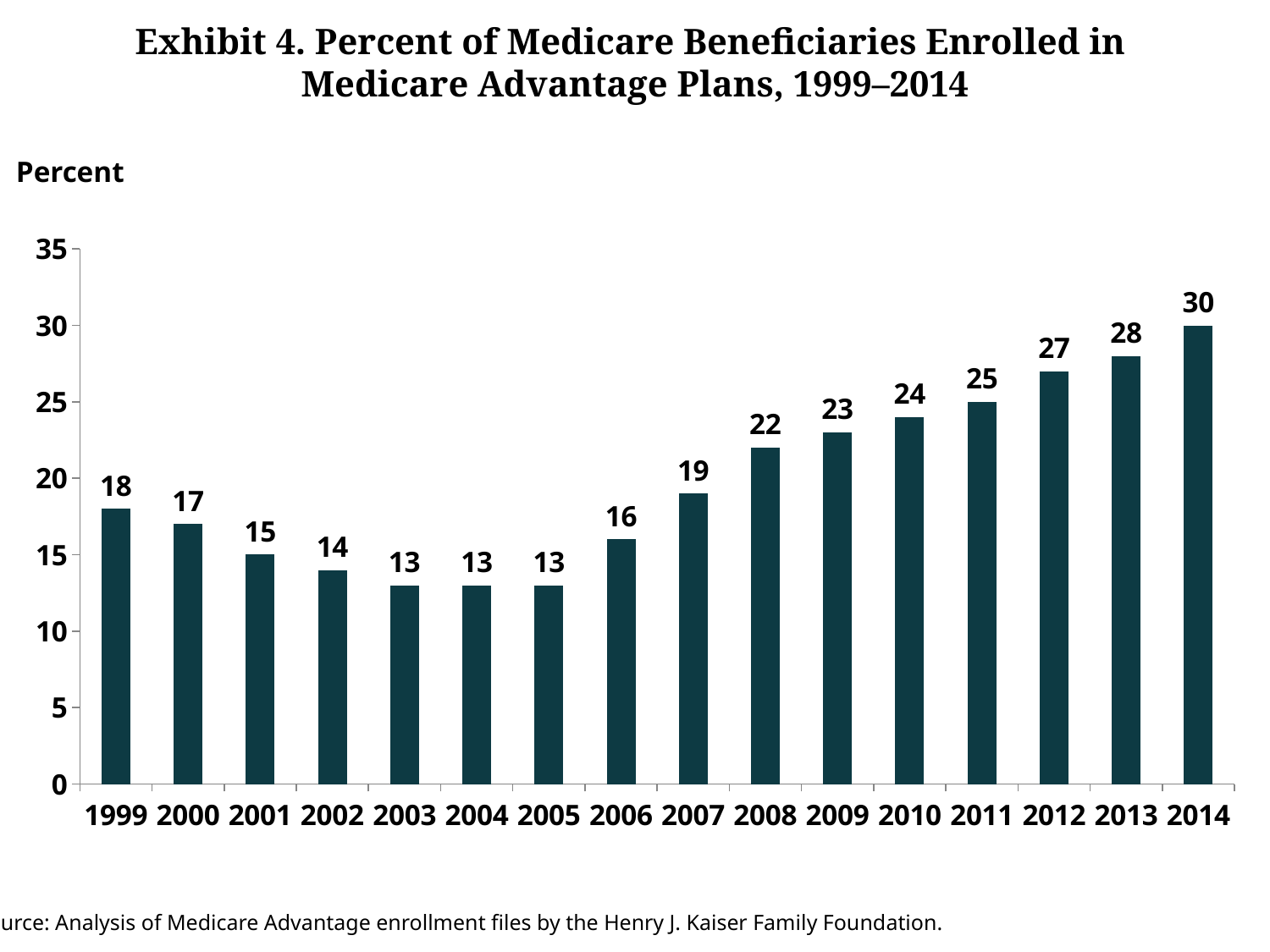
Which is larger, the value for 2000 or the value for 2006? 2000 What is the value for 1999? 18 What is the value for 2014? 30 What is the difference between the values for 2014 and 1999? 12 Which year has the highest value? 2014 What is the value for 2007? 19 What is the lowest value shown on the chart? 13 What kind of chart is this? Bar chart How many years are shown on the x axis? 16 Do the values rise or fall from 2005 to 2014? Rise What is the label on the vertical axis? Percent Is the value for 2012 greater or less than 25? greater